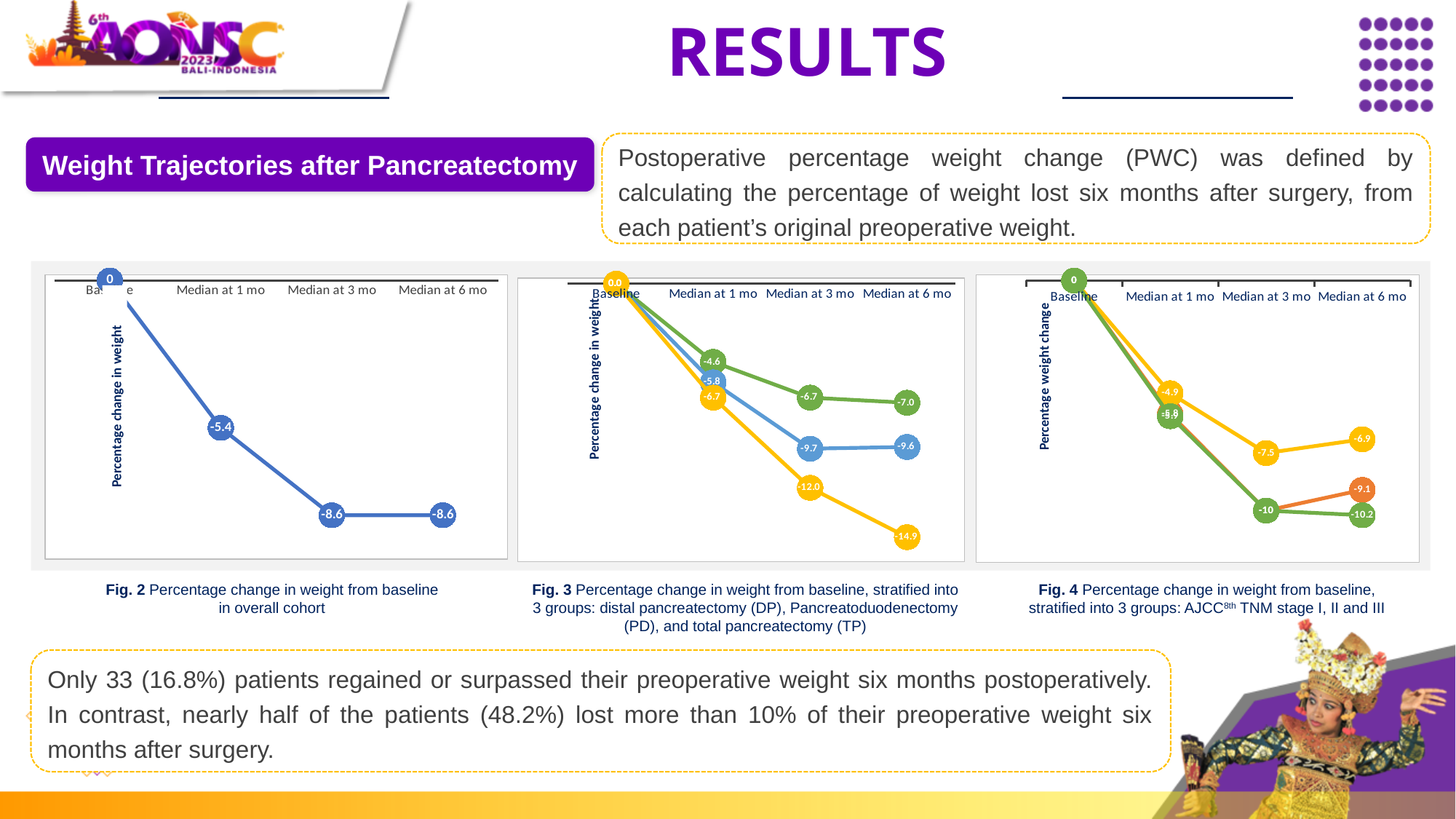
In Fig. 3, how many lines (groups) are plotted? 3 In Fig. 3, what is the value of the yellow line at Median at 3 mo? -12.0 In Fig. 4, what is the value of the yellow line at Median at 3 mo? -7.5 In Fig. 2, what is the difference between the values at Median at 1 mo and Median at 3 mo? 3.2 In Fig. 2, does the percentage change in weight rise or fall from Baseline to Median at 3 mo? Fall In Fig. 2, what is the percentage change in weight at Median at 1 mo? -5.4 In Fig. 3, what is the lowest value shown at Median at 6 mo? -14.9 What kind of chart is Fig. 2? Line chart In Fig. 4, what is the lowest value shown at Median at 6 mo? -10.2 In Fig. 3, what is the highest value shown at Median at 6 mo? -7.0 In Fig. 2, what is the percentage change in weight at Median at 6 mo? -8.6 In Fig. 2, how many time points are plotted along the x axis? 4